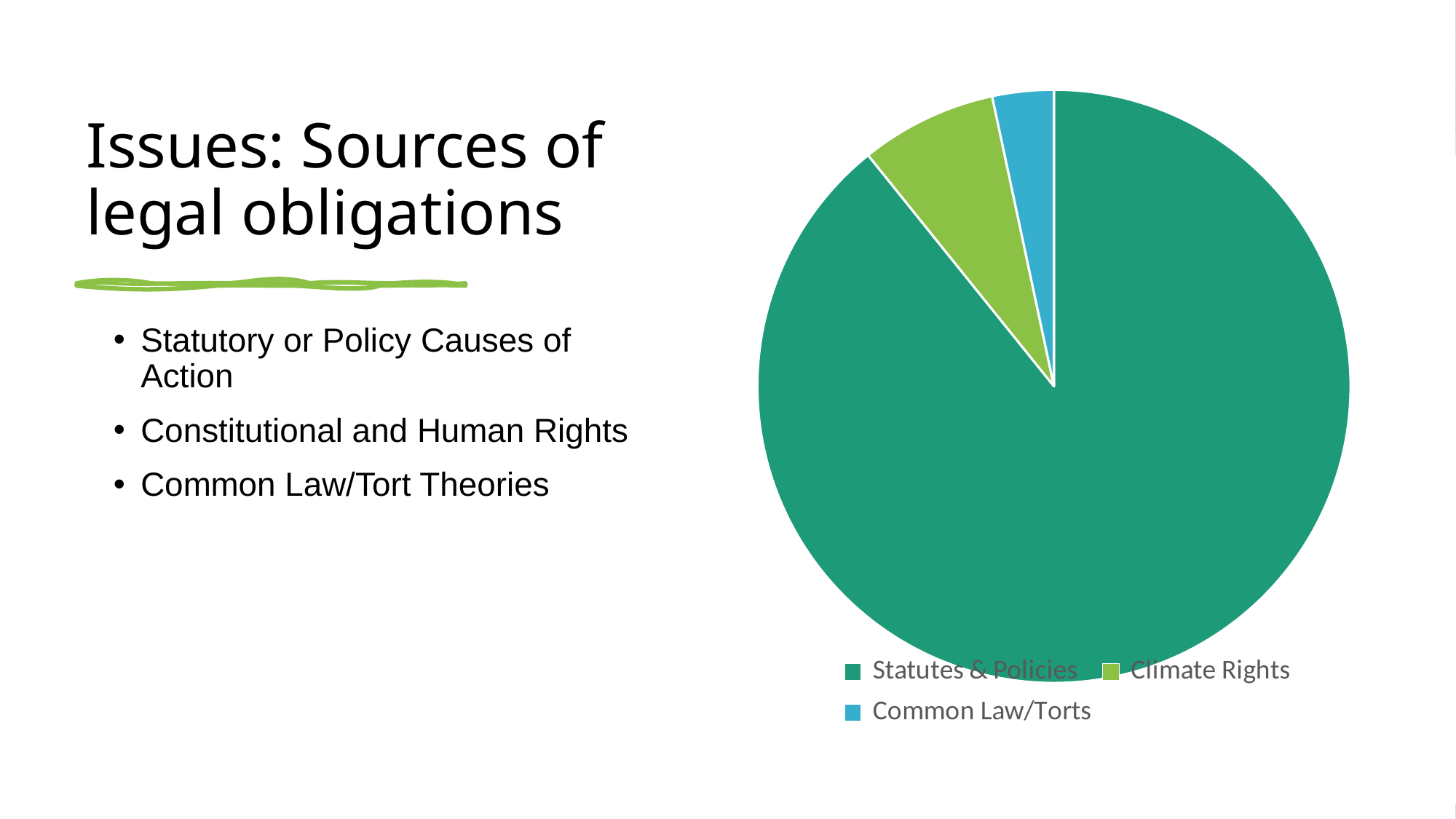
Which category has the smallest slice of the pie chart? Common Law/Torts Which slice is larger, Climate Rights or Common Law/Torts? Climate Rights Which category has the largest slice of the pie chart? Statutes & Policies Which slice is larger, Statutes & Policies or Climate Rights? Statutes & Policies What kind of chart is shown on the slide? pie chart What colour is the Statutes & Policies slice in the pie chart? teal green How many slices does the pie chart have? 3 What colour is the Common Law/Torts slice in the pie chart? blue How many entries does the pie chart's legend list? 3